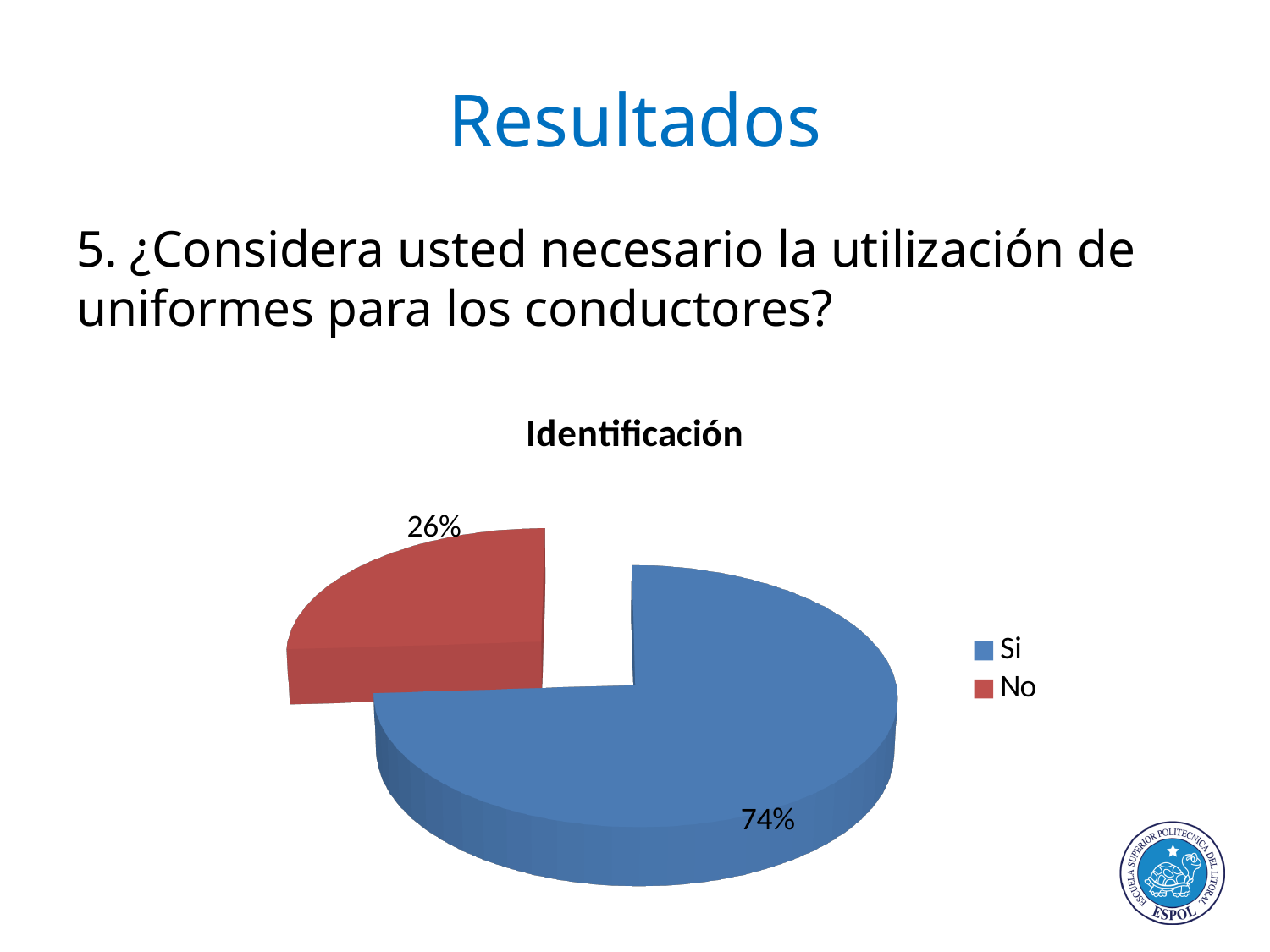
Is the share for "Si" greater or less than 50%? greater What type of chart is shown on the slide? Pie chart What is the title of the chart? Identificación What percentage of the pie corresponds to "No"? 26% What colour is the "No" slice? Red Which category has the smallest share of the pie? No Which slice is larger, "Si" or "No"? Si Which category has the largest share of the pie? Si What is the difference in percentage points between the "Si" and "No" slices? 48 How many categories does the pie chart show? 2 How many entries does the legend list? 2 What percentage of the pie corresponds to "Si"? 74%